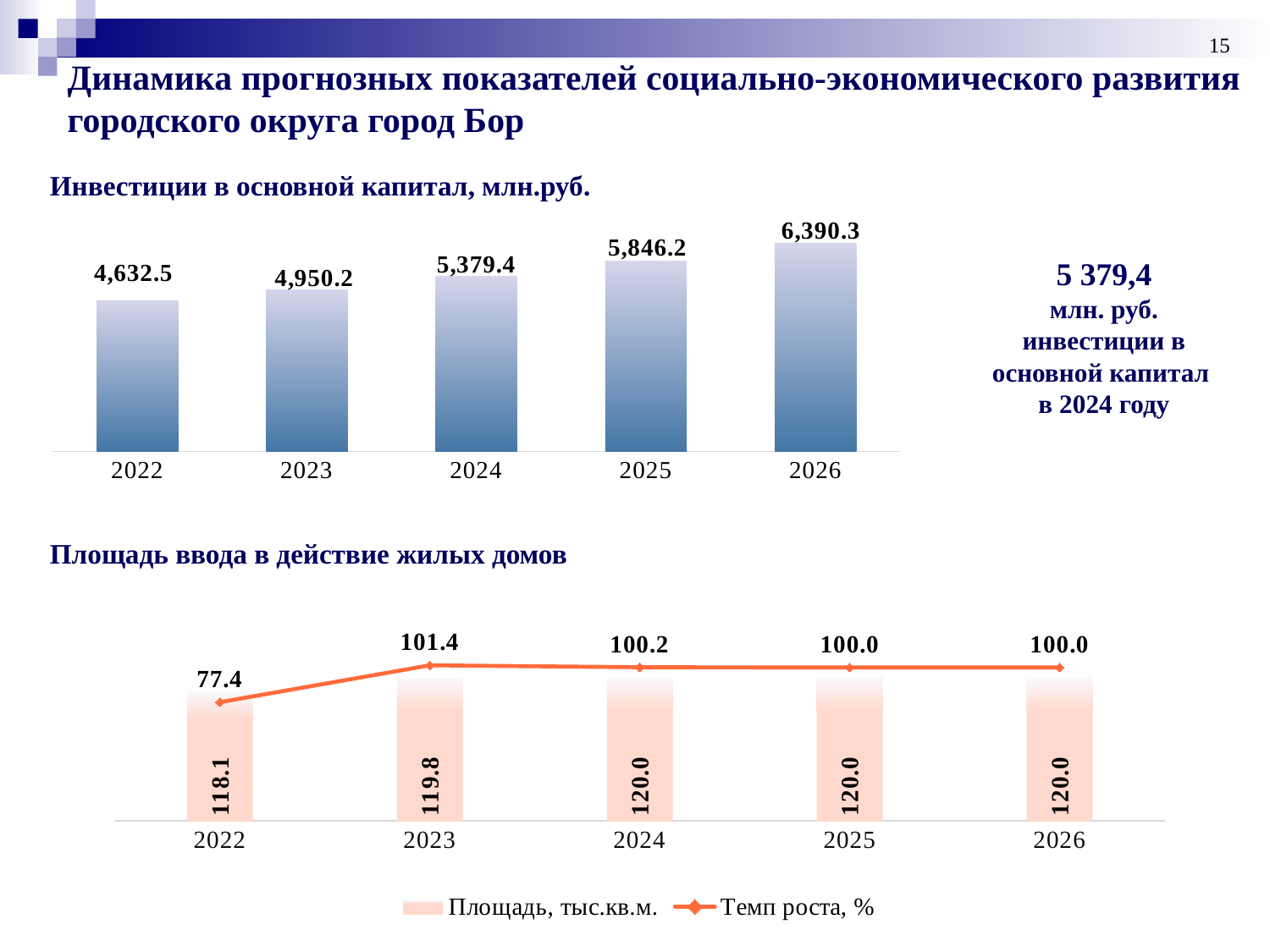
In the chart 'Площадь ввода в действие жилых домов', which year has the highest 'Темп роста, %'? 2023 In the chart 'Площадь ввода в действие жилых домов', what is the value of 'Темп роста, %' for 2022? 77.4 In the chart 'Инвестиции в основной капитал, млн.руб.', what is the difference between the values for 2026 and 2025? 544.1 In the chart 'Инвестиции в основной капитал, млн.руб.', which year has the highest value? 2026 How many years are shown in the chart 'Инвестиции в основной капитал, млн.руб.'? 5 What type of chart is 'Инвестиции в основной капитал, млн.руб.'? bar chart In the chart 'Площадь ввода в действие жилых домов', what is the value of 'Площадь, тыс.кв.м.' for 2023? 119.8 In the chart 'Инвестиции в основной капитал, млн.руб.', which year has the lowest value? 2022 How many series does the legend of the chart 'Площадь ввода в действие жилых домов' list? 2 In the chart 'Инвестиции в основной капитал, млн.руб.', what is the value for 2024? 5,379.4 In the chart 'Площадь ввода в действие жилых домов', what is the difference between 'Темп роста, %' for 2023 and 2022? 24.0 In the chart 'Инвестиции в основной капитал, млн.руб.', do the values rise or fall from 2022 to 2026? rise